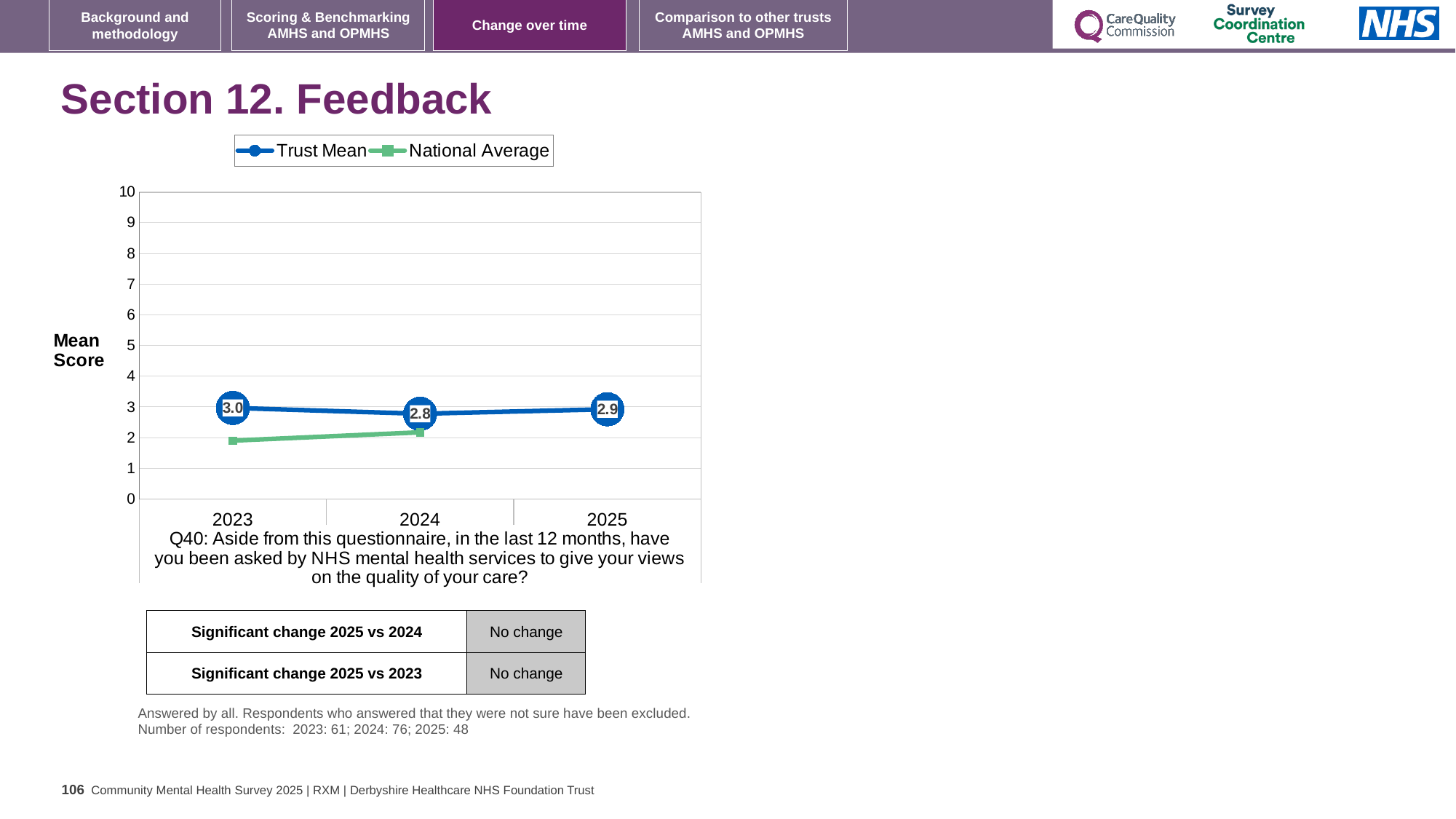
In which year is the Trust Mean highest? 2023 What is the difference between the Trust Mean in 2023 and in 2024? 0.2 What is the Trust Mean value for 2024? 2.8 Which is larger, the Trust Mean in 2025 or in 2024? 2025 In which year is the Trust Mean lowest? 2024 What is the Trust Mean value for 2023? 3.0 What is the Trust Mean value for 2025? 2.9 In 2023, which series has the higher value, Trust Mean or National Average? Trust Mean Is the National Average value for 2023 greater or less than 3? less How many years are shown on the x axis? 3 What kind of chart is shown on the slide? Line chart How many series does the legend list? 2